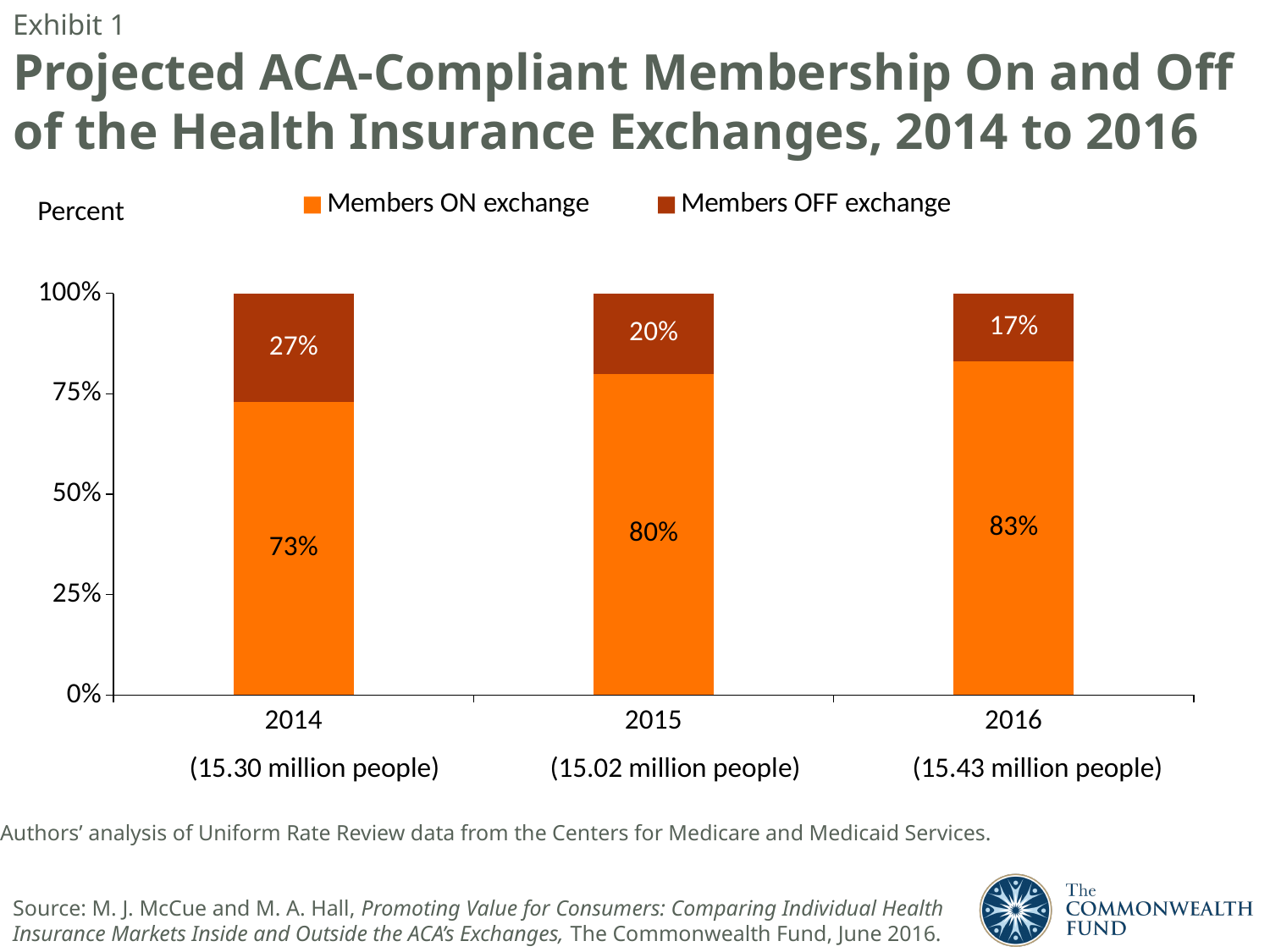
Which year has the lowest share of members OFF exchange? 2016 What kind of chart is shown on the slide? stacked bar chart How many years are shown on the x axis? 3 What percentage of members were OFF exchange in 2015? 20% Which is larger: the OFF exchange share in 2014 or in 2015? 2014 Does the share of members ON exchange rise or fall from 2014 to 2016? rise What is the difference between the ON exchange share in 2016 and in 2014? 10% Which year has the highest share of members ON exchange? 2016 What percentage of members were ON exchange in 2014? 73% How many series does the legend list? 2 What percentage of members were OFF exchange in 2016? 17% What is the total membership noted for 2015? 15.02 million people